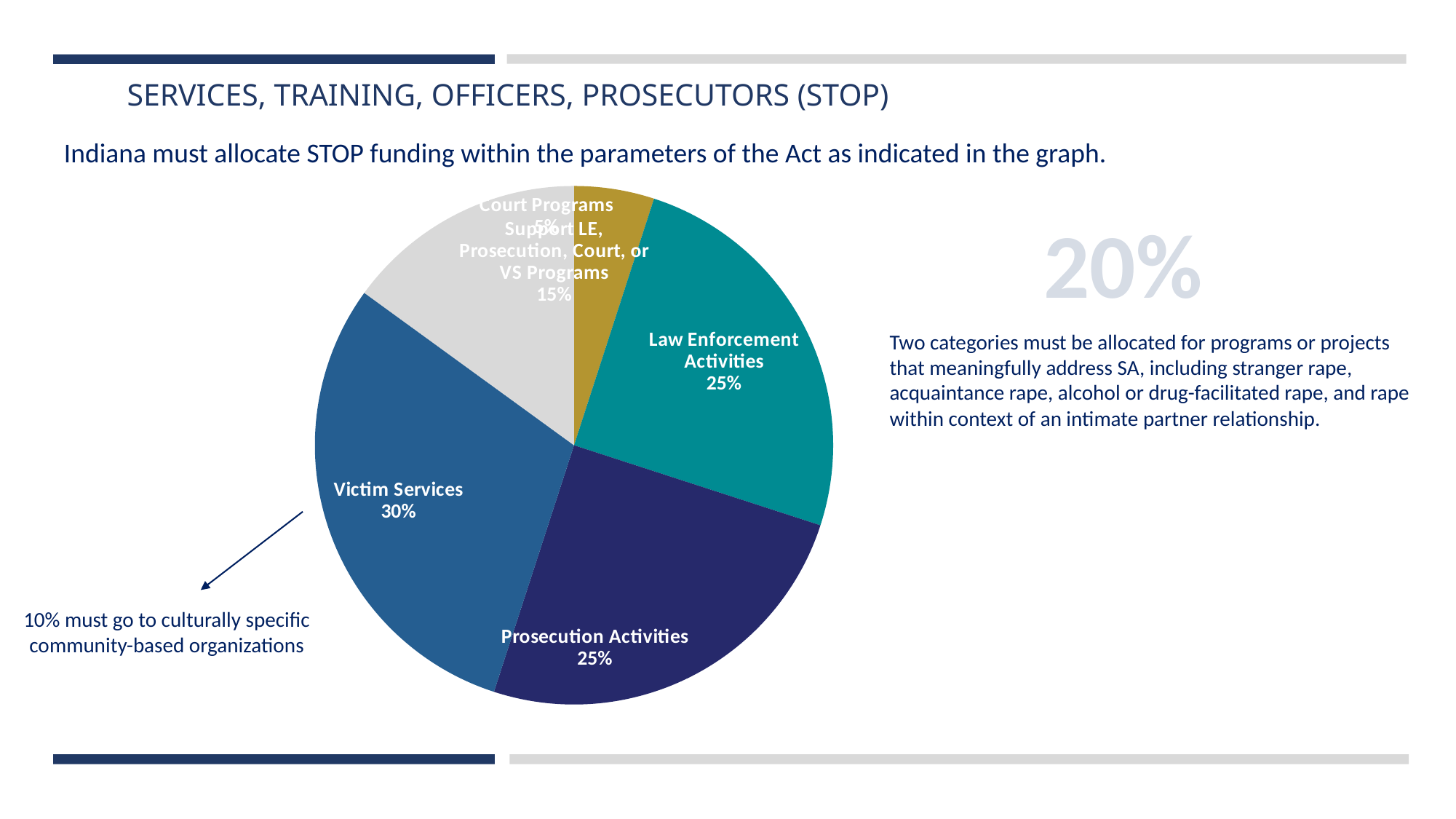
Which is larger, the share for Victim Services or the share for Support LE, Prosecution, Court, or VS Programs? Victim Services Which category receives the largest share of STOP funding? Victim Services Which category receives the smallest share of STOP funding? Court Programs What colour is the Law Enforcement Activities slice? teal How many slices does the pie chart have? 5 What is the difference between the Victim Services share and the Law Enforcement Activities share? 5% What percentage is allocated to Law Enforcement Activities? 25% What percentage is allocated to Court Programs? 5% What percentage is allocated to Prosecution Activities? 25% What percentage is allocated to Support LE, Prosecution, Court, or VS Programs? 15% What percentage of STOP funding is allocated to Victim Services? 30% What type of chart is shown on the slide? pie chart